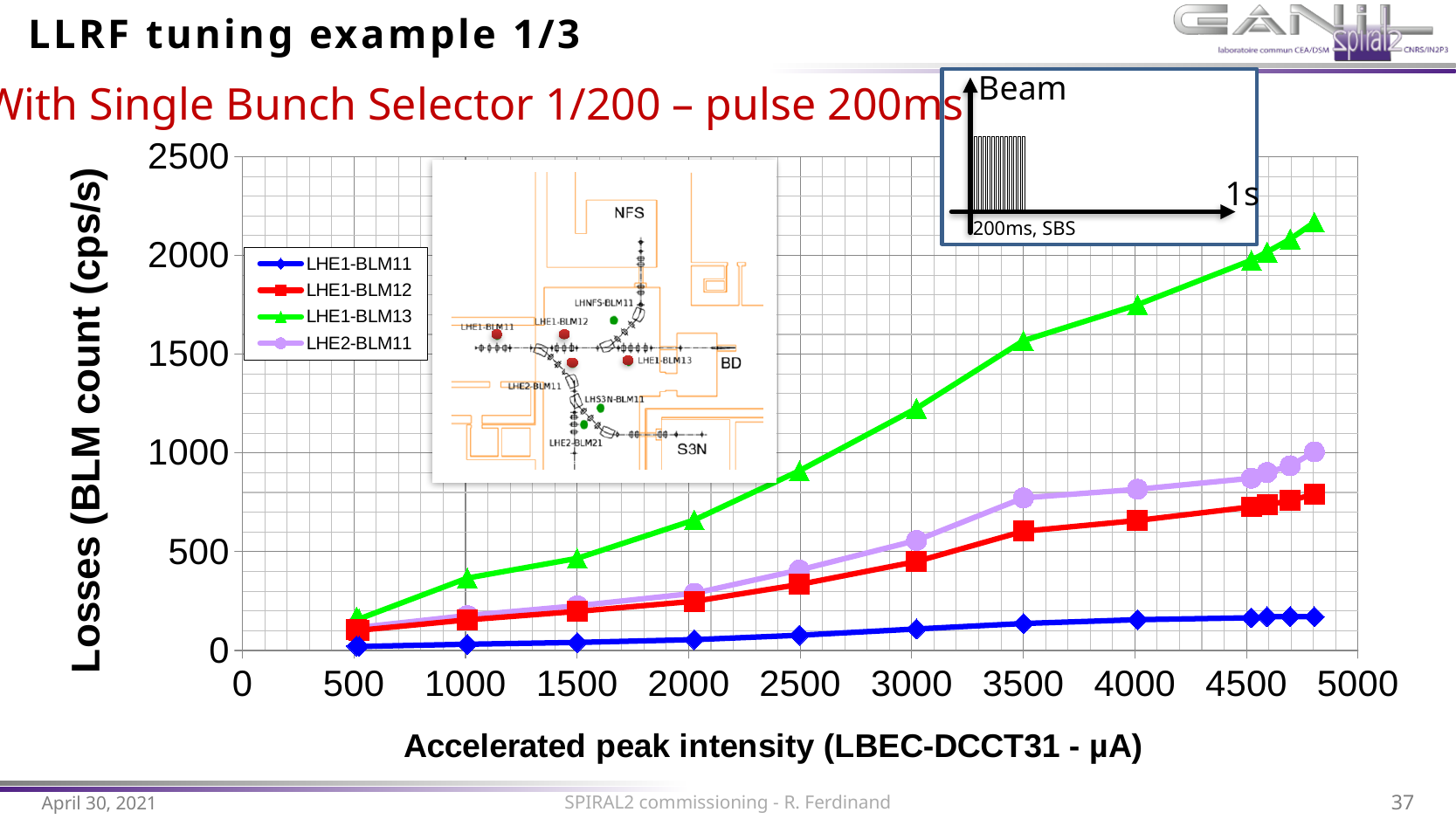
What is the title of the vertical axis of the chart? Losses (BLM count (cps/s) At 3500 µA, which series has the larger value, LHE2-BLM11 or LHE1-BLM12? LHE2-BLM11 Which series shows the lowest losses at 4000 µA? LHE1-BLM11 What is the title of the horizontal axis of the chart? Accelerated peak intensity (LBEC-DCCT31 - µA) Is the value for LHE1-BLM13 at 3000 µA greater or less than 1000? greater What kind of chart is shown on the slide? line chart Is the value for LHE1-BLM12 at 2500 µA greater or less than 500? less Do the losses for LHE1-BLM13 rise or fall as the accelerated peak intensity increases? rise Which series shows the highest losses at 4000 µA? LHE1-BLM13 Is the value for LHE1-BLM11 at 4500 µA greater or less than 500? less How many series does the chart legend list? 4